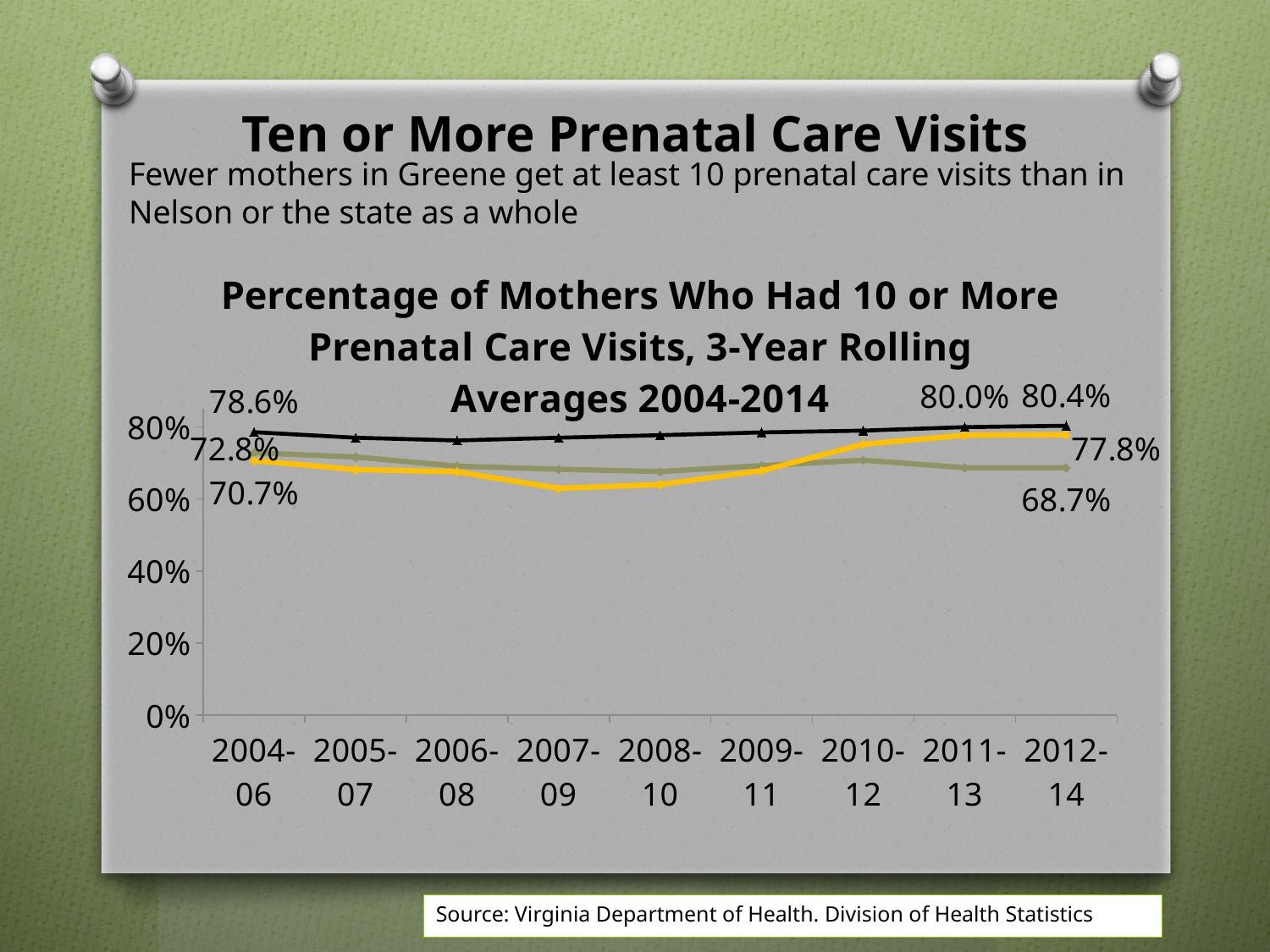
What is the value of the yellow line for 2012-14? 77.8% What is the title of the chart? Percentage of Mothers Who Had 10 or More Prenatal Care Visits, 3-Year Rolling Averages 2004-2014 What is the value of the olive-green line for 2012-14? 68.7% What is the value of the black line for 2012-14? 80.4% At 2012-14, which line has the higher value, the yellow line or the olive-green line? the yellow line How many time periods are shown on the x axis of the chart? 9 Is the value of the yellow line for 2007-09 greater or less than 80%? less What is the value of the black line for 2011-13? 80.0% What kind of chart is shown on the slide? line chart What is the value of the black line for 2004-06? 78.6% By how many percentage points did the yellow line increase from 2004-06 to 2012-14? 7.1 percentage points What is the value of the yellow line for 2004-06? 70.7%